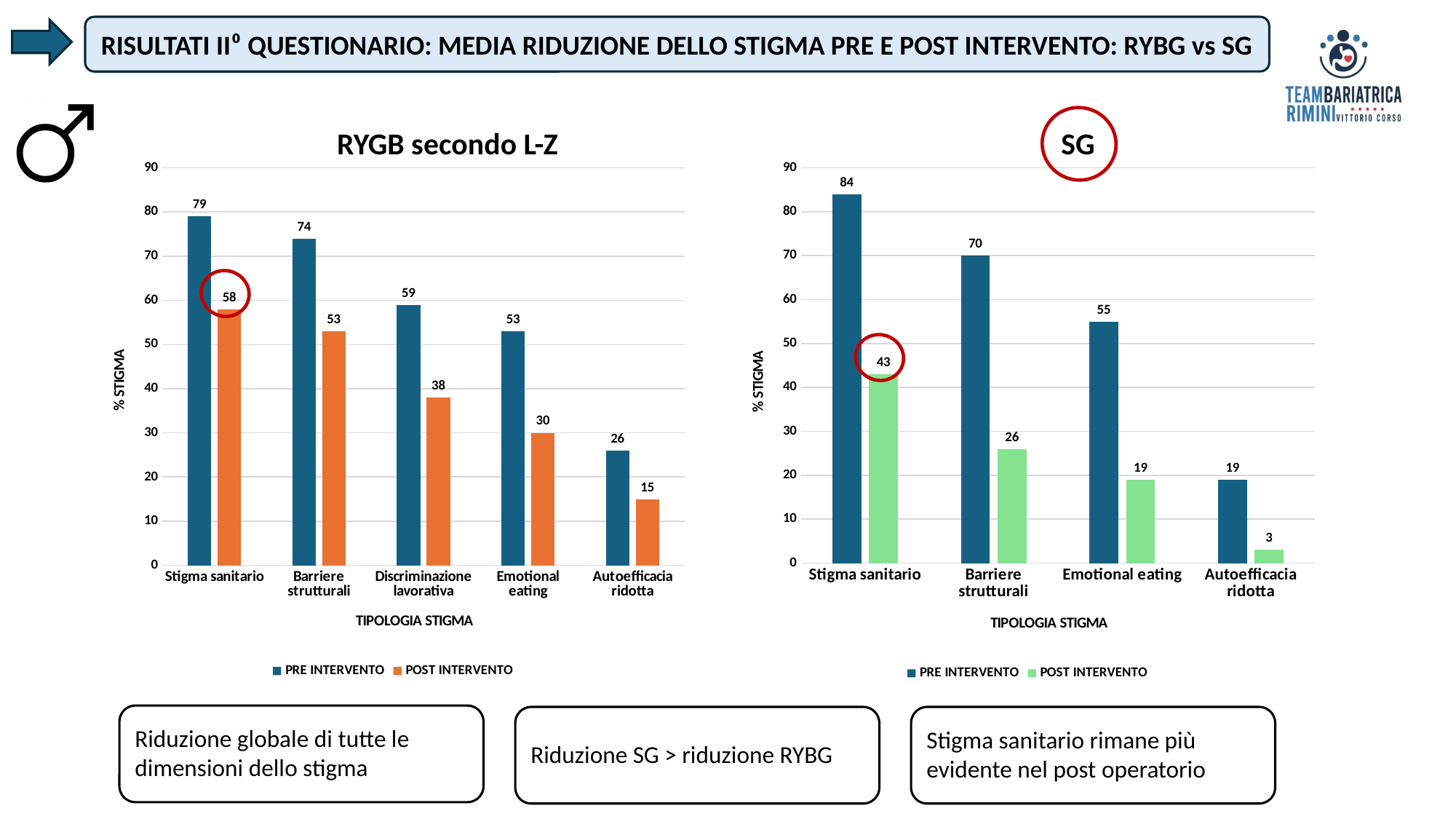
How many categories are shown on the x axis of the 'RYGB secondo L-Z' chart? 5 What kind of chart is the 'SG' chart? Bar chart In the 'RYGB secondo L-Z' chart, what is the POST INTERVENTO value for Discriminazione lavorativa? 38 How many series does the legend of the 'SG' chart list? 2 In the 'RYGB secondo L-Z' chart, what is the PRE INTERVENTO value for Stigma sanitario? 79 In the 'SG' chart, which category has the lowest POST INTERVENTO value? Autoefficacia ridotta In the 'SG' chart, what is the difference between the PRE and POST INTERVENTO values for Barriere strutturali? 44 In the 'RYGB secondo L-Z' chart, which category has the highest PRE INTERVENTO value? Stigma sanitario In the 'SG' chart, what is the PRE INTERVENTO value for Emotional eating? 55 In the 'SG' chart, what is the POST INTERVENTO value for Stigma sanitario? 43 In the 'RYGB secondo L-Z' chart, what is the difference between the PRE and POST INTERVENTO values for Emotional eating? 23 Is the POST INTERVENTO value for Stigma sanitario larger in the 'RYGB secondo L-Z' chart or in the 'SG' chart? RYGB secondo L-Z